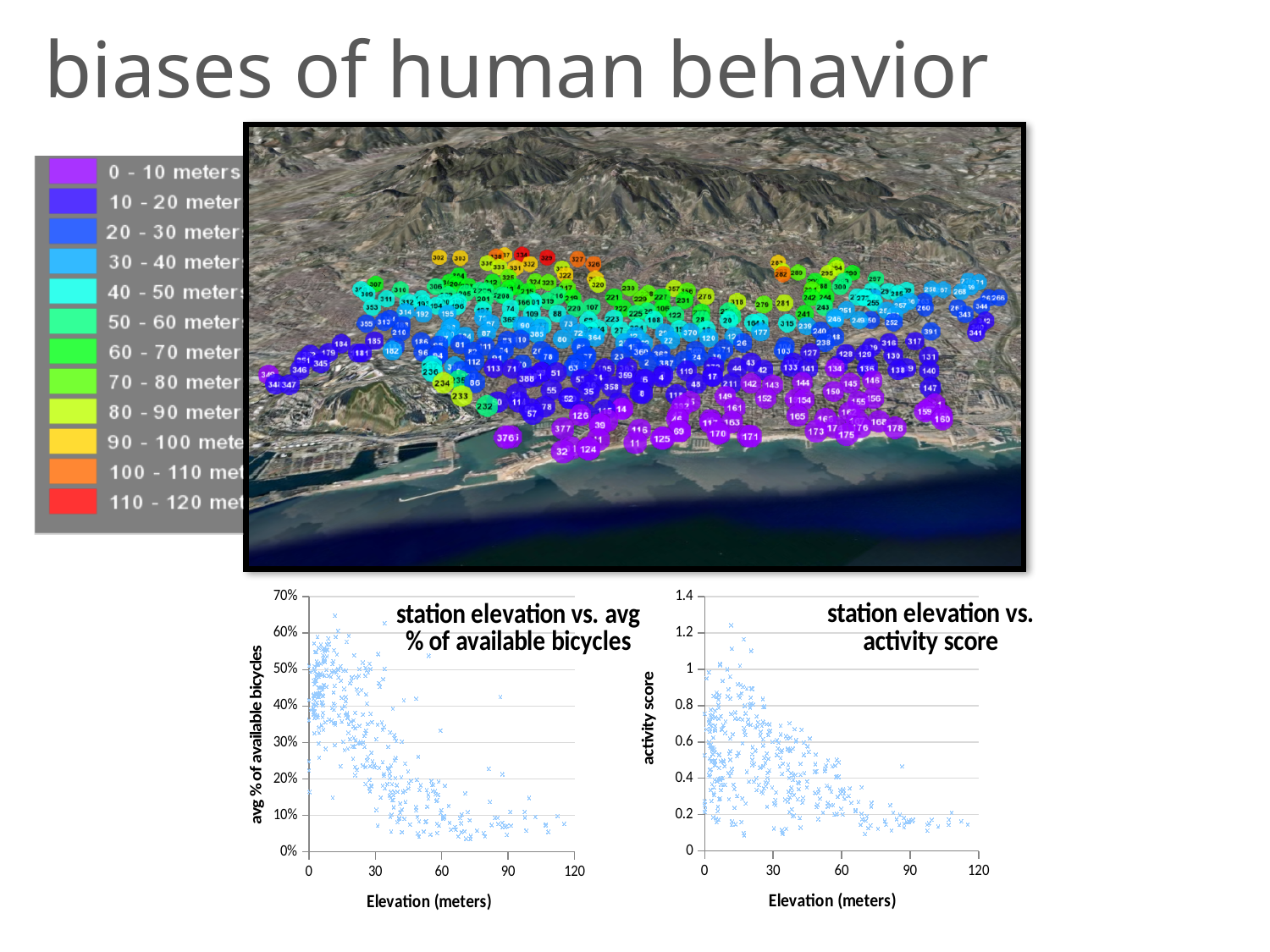
What kind of chart is the left chart titled "station elevation vs. avg % of available bicycles"? scatter chart In the right chart, "station elevation vs. activity score", does the activity score generally rise or fall as elevation increases? fall What is the x-axis label of the left chart, "station elevation vs. avg % of available bicycles"? Elevation (meters) What kind of chart is the right chart titled "station elevation vs. activity score"? scatter chart What is the y-axis label of the right chart, "station elevation vs. activity score"? activity score In the left chart, "station elevation vs. avg % of available bicycles", does the avg % of available bicycles generally rise or fall as elevation increases? fall